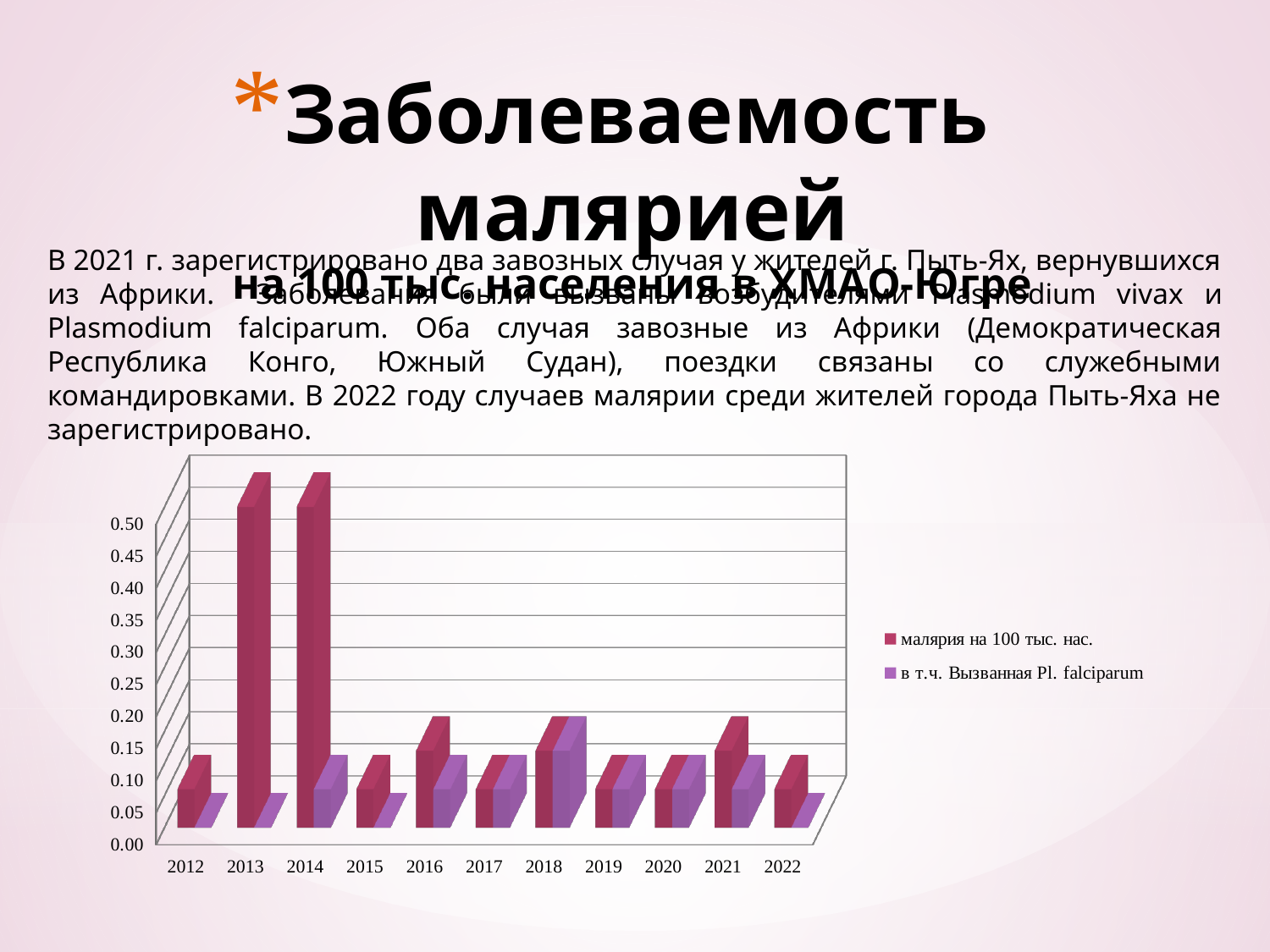
Is the value for 'малярия на 100 тыс. нас.' in 2022 greater or less than 0.20? less Which year has the larger value for 'малярия на 100 тыс. нас.', 2014 or 2022? 2014 Is the value for 'малярия на 100 тыс. нас.' in 2013 greater or less than 0.40? greater Does the value for 'малярия на 100 тыс. нас.' rise or fall from 2014 to 2015? fall What kind of chart is shown on the slide? bar chart What is the first series listed in the chart's legend? малярия на 100 тыс. нас. Is the value for 'малярия на 100 тыс. нас.' in 2014 greater or less than 0.40? greater How many series does the chart's legend list? 2 What is the second series listed in the chart's legend? в т.ч. Вызванная Pl. falciparum How many years are shown on the x axis of the chart? 11 Which year has the larger value for 'малярия на 100 тыс. нас.', 2013 or 2016? 2013